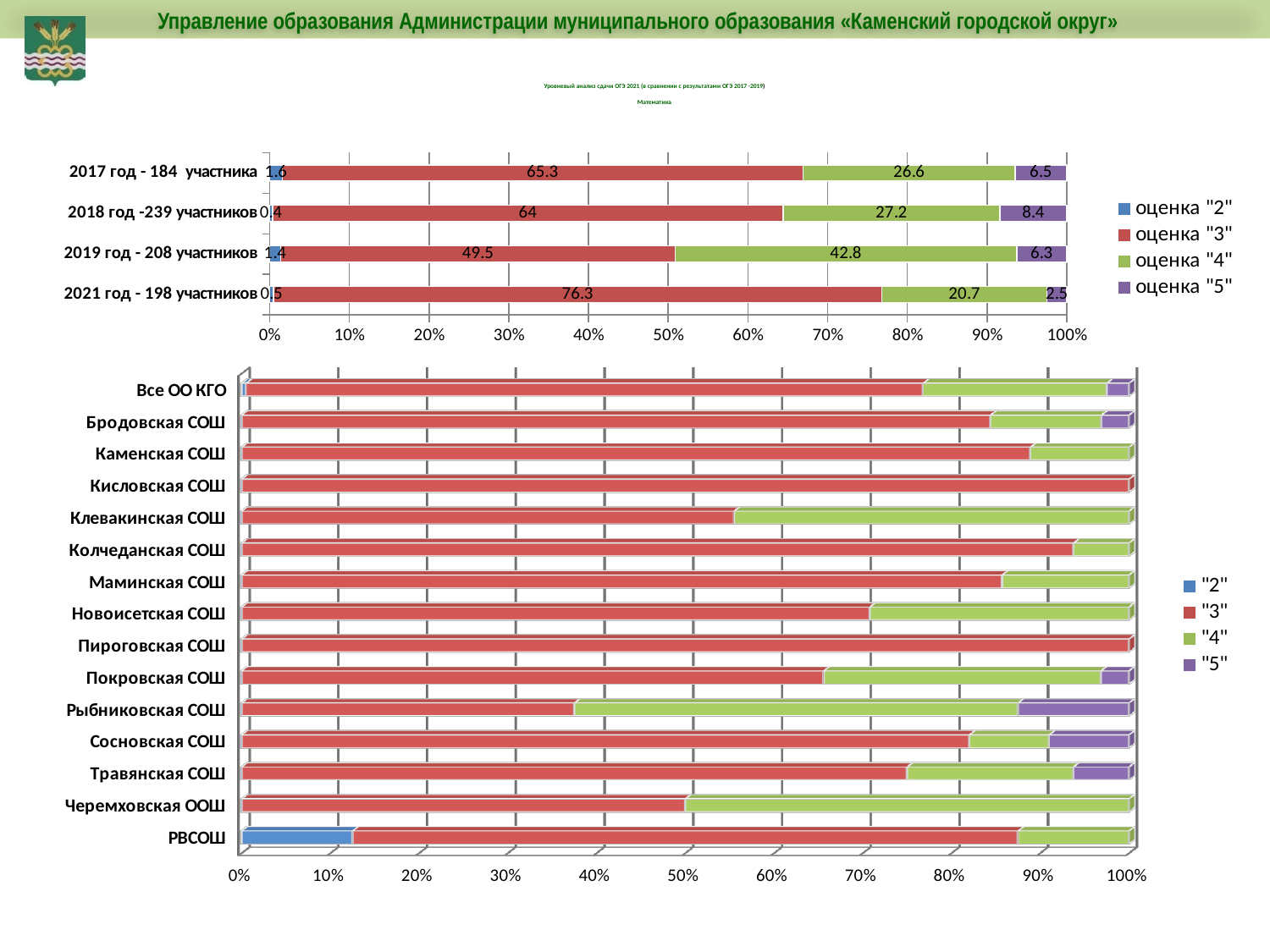
In the bottom chart, is the value for "2" at РВСОШ greater or less than 10%? greater How many series does the legend of the top chart list? 4 In the top chart, which year has the lowest value for оценка "5"? 2021 год - 198 участников In the top chart, which year has the highest value for оценка "3"? 2021 год - 198 участников In the top chart, what is the value for оценка "5" in 2018 год -239 участников? 8.4 What kind of chart is the bottom chart? stacked bar chart In the top chart, what is the value for оценка "3" in 2017 год - 184 участника? 65.3 In the top chart, what is the difference between the оценка "4" values for 2019 год - 208 участников and 2021 год - 198 участников? 22.1 In the top chart, which is larger: оценка "3" in 2018 год -239 участников or оценка "3" in 2019 год - 208 участников? 2018 год -239 участников In the top chart, what is the value for оценка "4" in 2019 год - 208 участников? 42.8 How many schools (categories) are shown in the bottom chart? 15 In the bottom chart, is the value for "3" at Рыбниковская СОШ greater or less than 40%? less